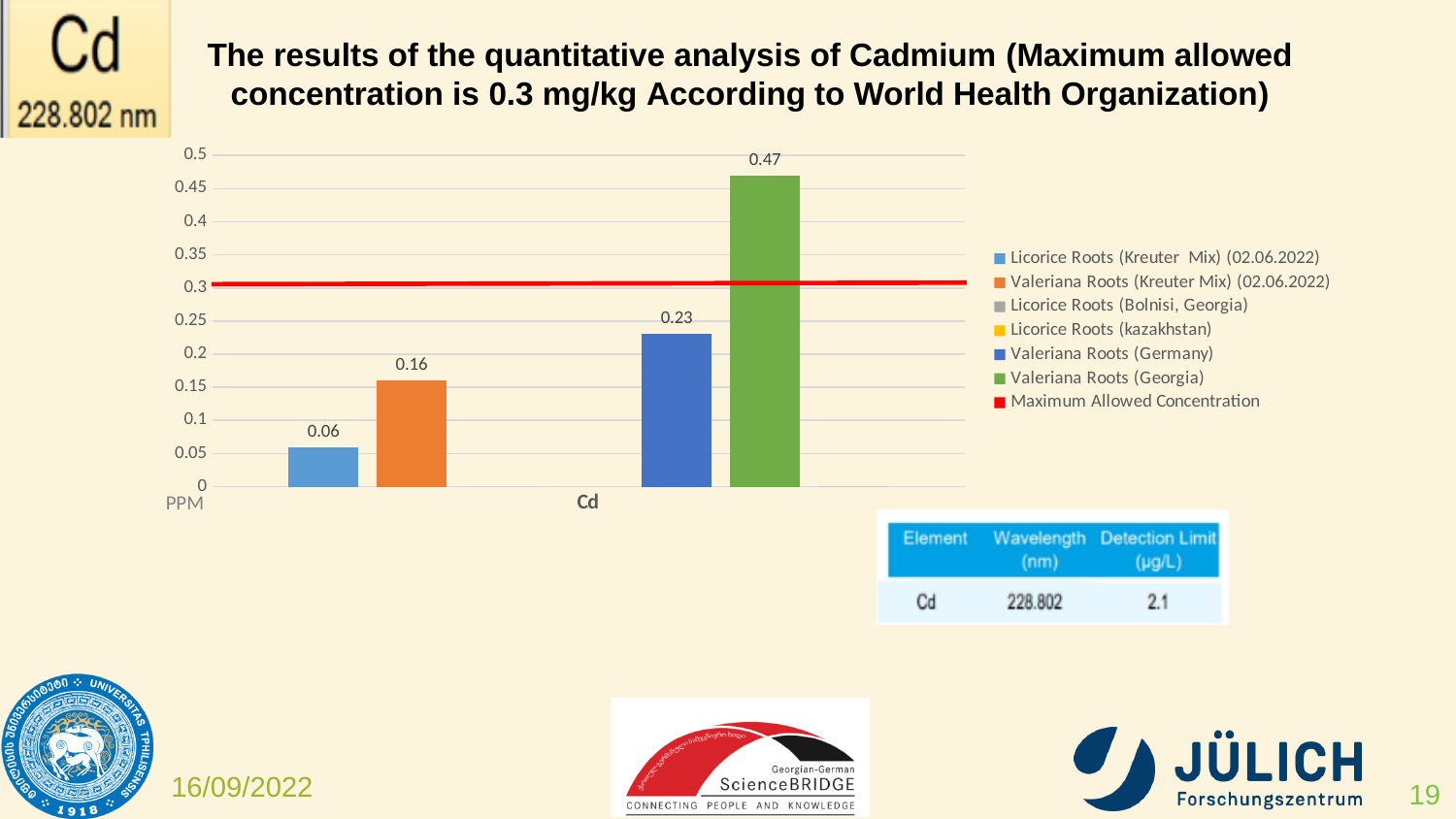
Which series has the highest bar in the Cadmium chart? Valeriana Roots (Georgia) Among the bars with data labels in the Cadmium chart, which series has the lowest value? Licorice Roots (Kreuter Mix) (02.06.2022) What is the difference between the values for Valeriana Roots (Georgia) and Valeriana Roots (Germany)? 0.24 Which is larger: the value for Valeriana Roots (Kreuter Mix) or the value for Valeriana Roots (Germany)? Valeriana Roots (Germany) What is the value for Valeriana Roots (Kreuter Mix) (02.06.2022) in the Cadmium chart? 0.16 Is the value for Valeriana Roots (Georgia) greater or less than 0.3? greater What does the red horizontal line in the chart represent? Maximum Allowed Concentration What kind of chart is shown on the slide? bar chart What is the value for Valeriana Roots (Georgia) in the Cadmium chart? 0.47 What is the value for Valeriana Roots (Germany) in the Cadmium chart? 0.23 How many entries does the legend of the Cadmium chart list? 7 What is the value for Licorice Roots (Kreuter Mix) (02.06.2022) in the Cadmium chart? 0.06